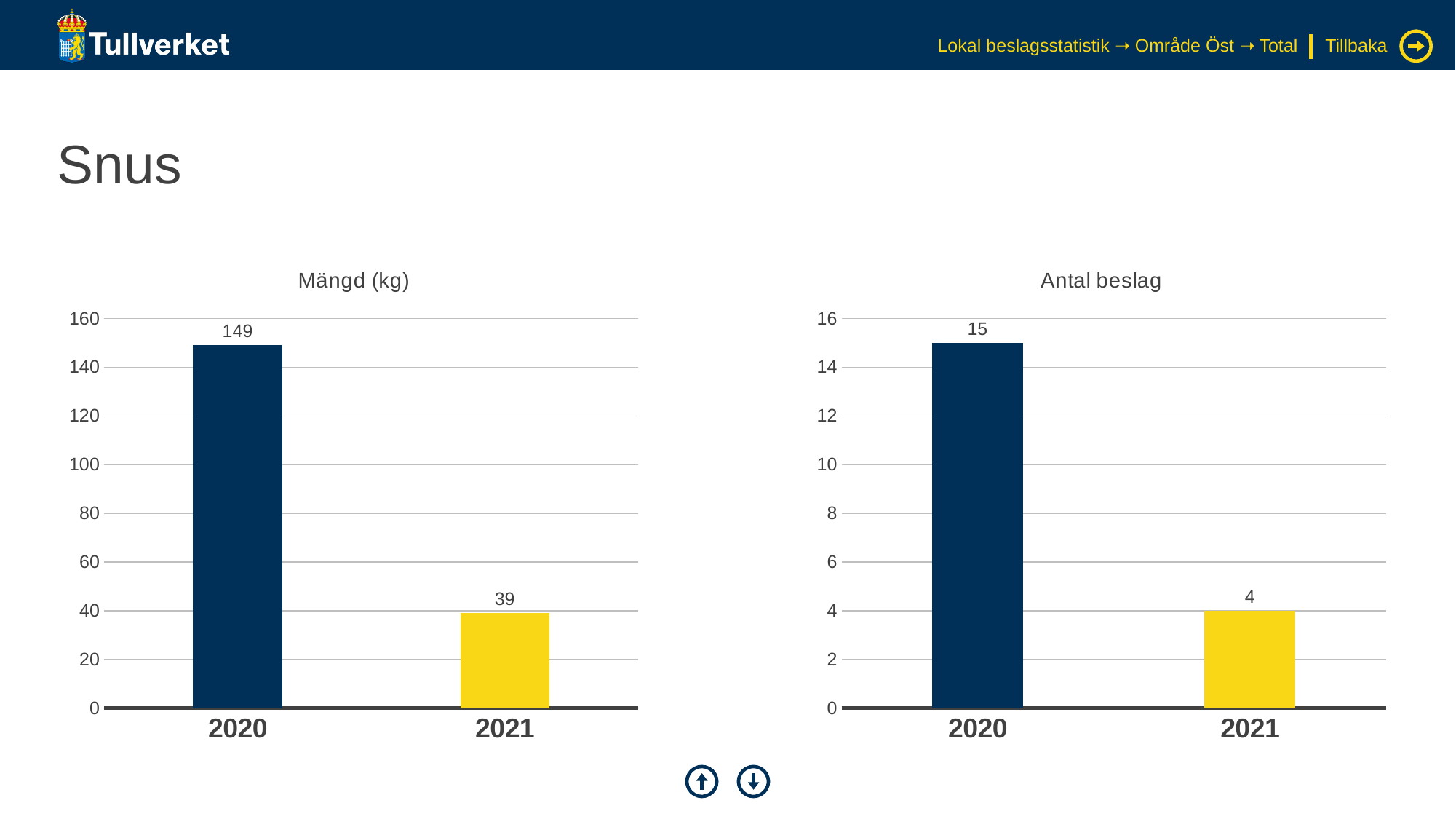
In the 'Mängd (kg)' chart, what is the value for 2020? 149 In the 'Mängd (kg)' chart, which year has the highest value? 2020 In the 'Antal beslag' chart, which year has the lowest value? 2021 In the 'Antal beslag' chart, what is the difference between the 2020 and 2021 values? 11 In the 'Antal beslag' chart, what is the value for 2020? 15 How many categories are shown on the x axis of the 'Mängd (kg)' chart? 2 In the 'Mängd (kg)' chart, is the value for 2020 greater or less than 140? greater What kind of chart is the 'Antal beslag' chart? bar chart In the 'Antal beslag' chart, what is the value for 2021? 4 In the 'Mängd (kg)' chart, what is the value for 2021? 39 In the 'Antal beslag' chart, which is larger, the value for 2020 or 2021? 2020 In the 'Mängd (kg)' chart, what is the difference between the 2020 and 2021 values? 110